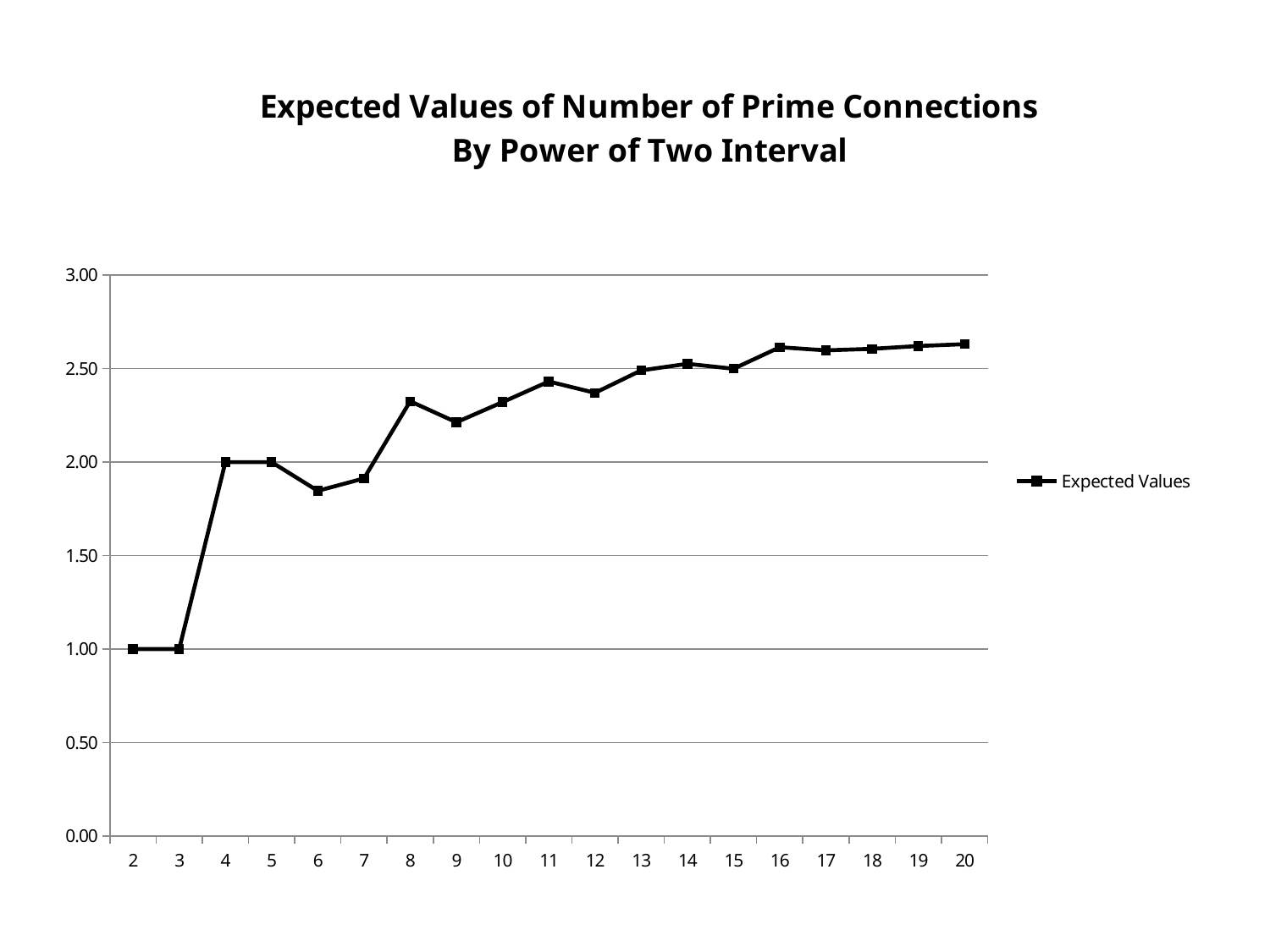
How many series does the legend list? 1 How many points are plotted along the x axis? 19 What is the title of the chart? Expected Values of Number of Prime Connections By Power of Two Interval What is the expected value at x = 4? 2.00 What is the name of the series shown in the legend? Expected Values What kind of chart is shown on the slide? line chart Is the expected value at x = 16 greater or less than 2.50? greater Is the expected value at x = 8 greater or less than 2.00? greater Which x value has the lowest expected value, 3 or 20? 3 Do the expected values generally rise or fall as x increases from 2 to 20? rise Is the expected value at x = 6 greater or less than 2.00? less What is the expected value at x = 2? 1.00